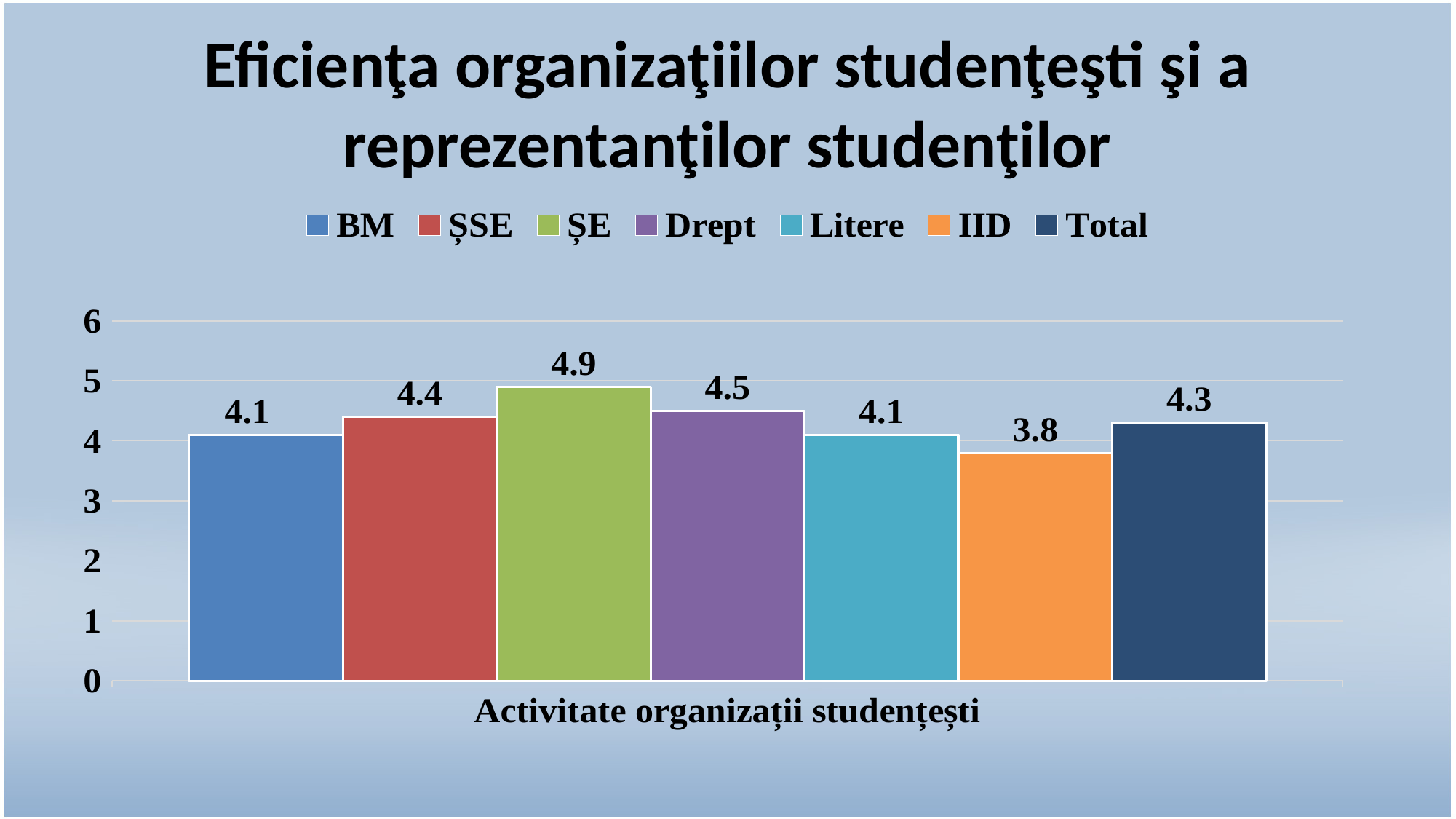
What is the difference between the values for ȘE and IID? 1.1 Which series has the highest value? ȘE What is the value for ȘE? 4.9 What is the label on the x axis of the chart? Activitate organizații studențești Which is larger, the value for ȘSE or the value for Drept? Drept How many series does the legend list? 7 Is the value for IID greater or less than 4? less Which series has the lowest value? IID What kind of chart is shown on the slide? bar chart What is the value for IID? 3.8 What is the value for Total? 4.3 What is the value for Drept? 4.5